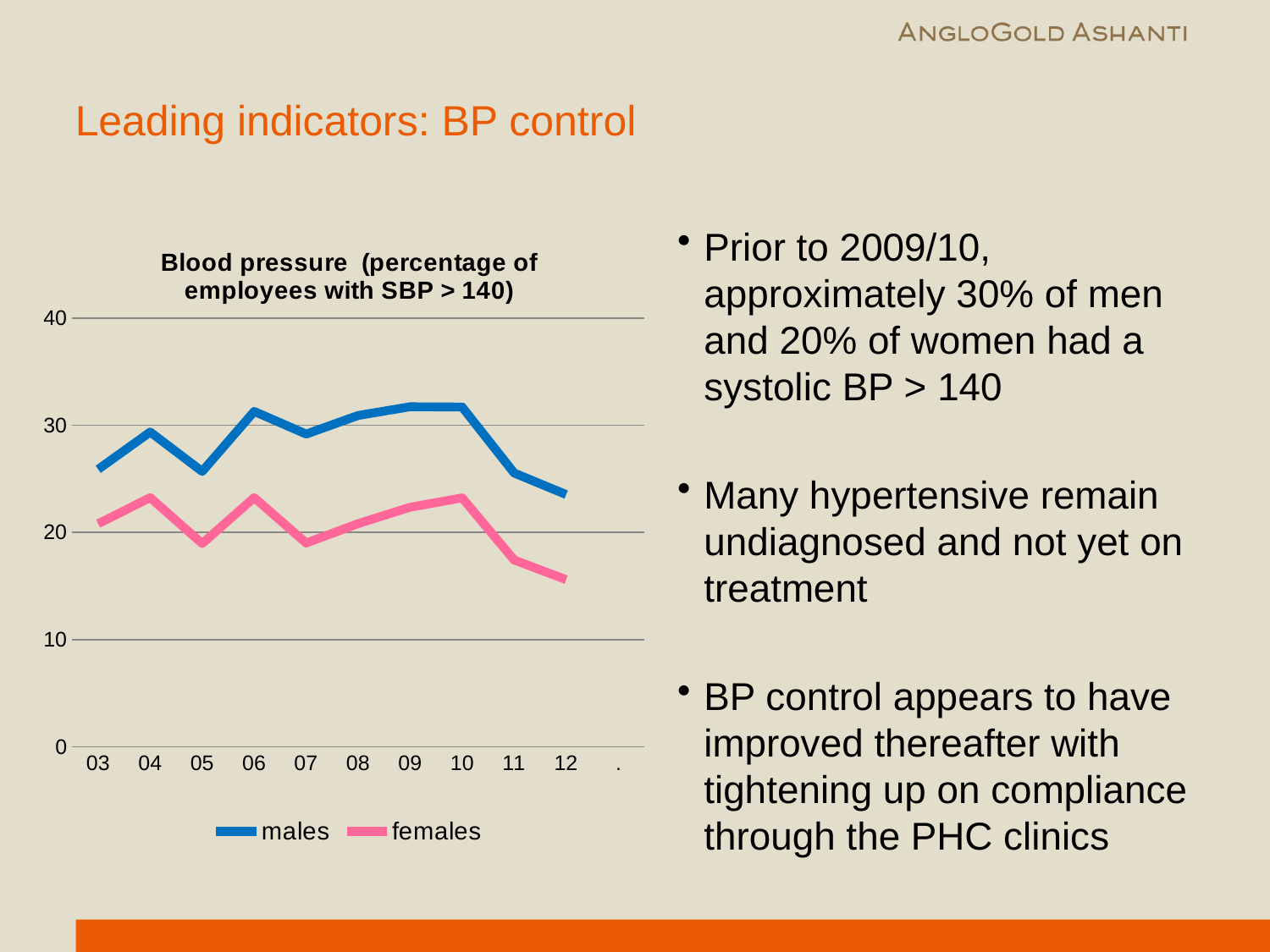
Which is larger in 08, the value for males or the value for females? males Is the value for females in 11 greater or less than 20? less Which two series are shown in the legend? males and females Is the value for males in 12 greater or less than 20? greater Do the values for males rise or fall from 10 to 12? fall Is the value for males in 03 greater or less than 30? less How many series does the legend list? 2 What kind of chart is shown on the slide? line chart What colour is the line for females? pink Do the values for females rise or fall from 10 to 12? fall